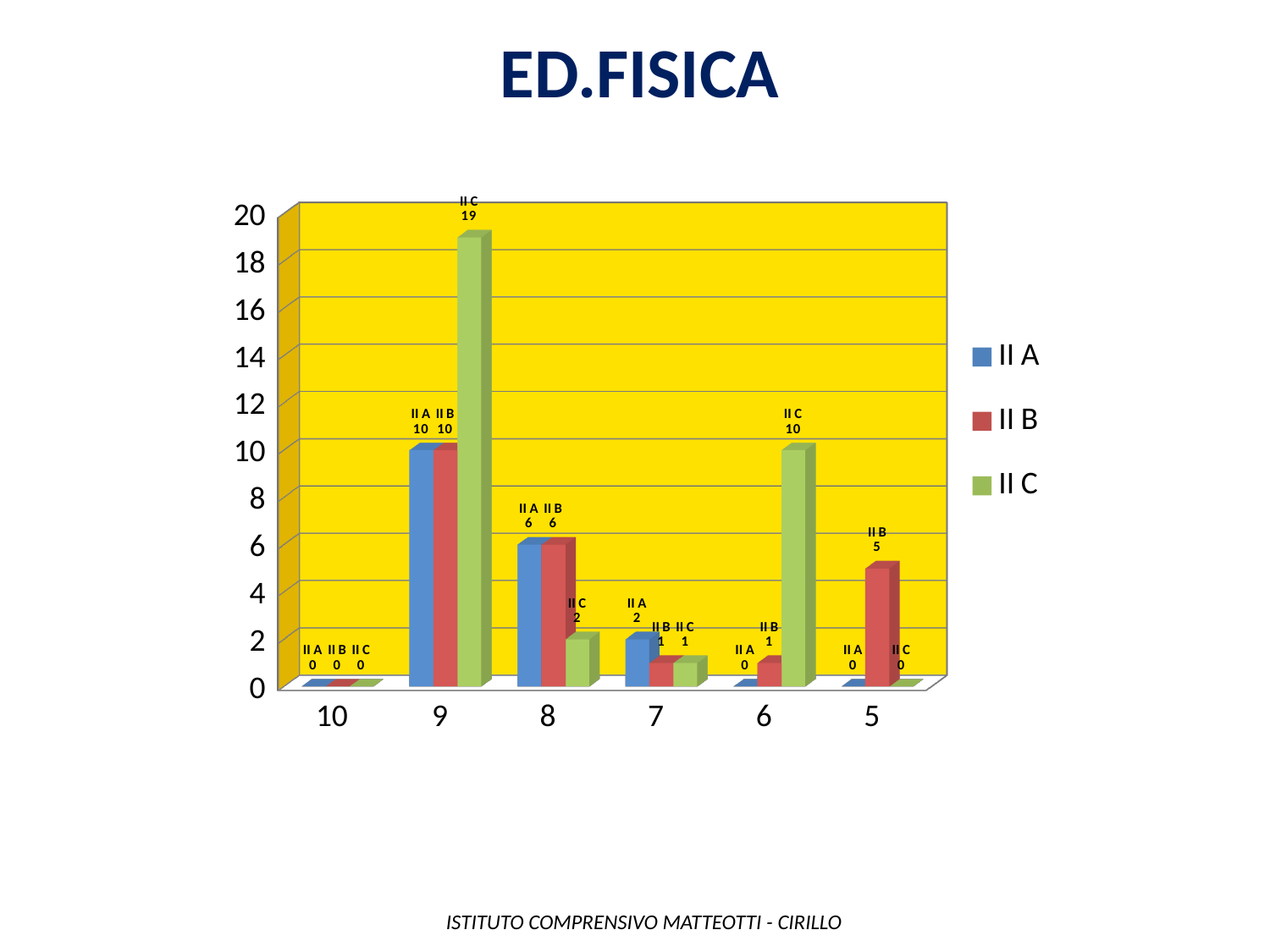
How many series does the legend list? 3 Which is larger at grade 8, II A or II C? II A Which grade has the highest value for II C? 9 What is the title of the chart? ED.FISICA Which grade has the highest value for II A? 9 What kind of chart is shown? bar chart What is the difference between II C and II A at grade 9? 9 What is the value for II A at grade 8? 6 What is the value for II C at grade 9? 19 How many grade categories are shown on the x axis? 6 What is the value for II C at grade 6? 10 What is the value for II B at grade 5? 5